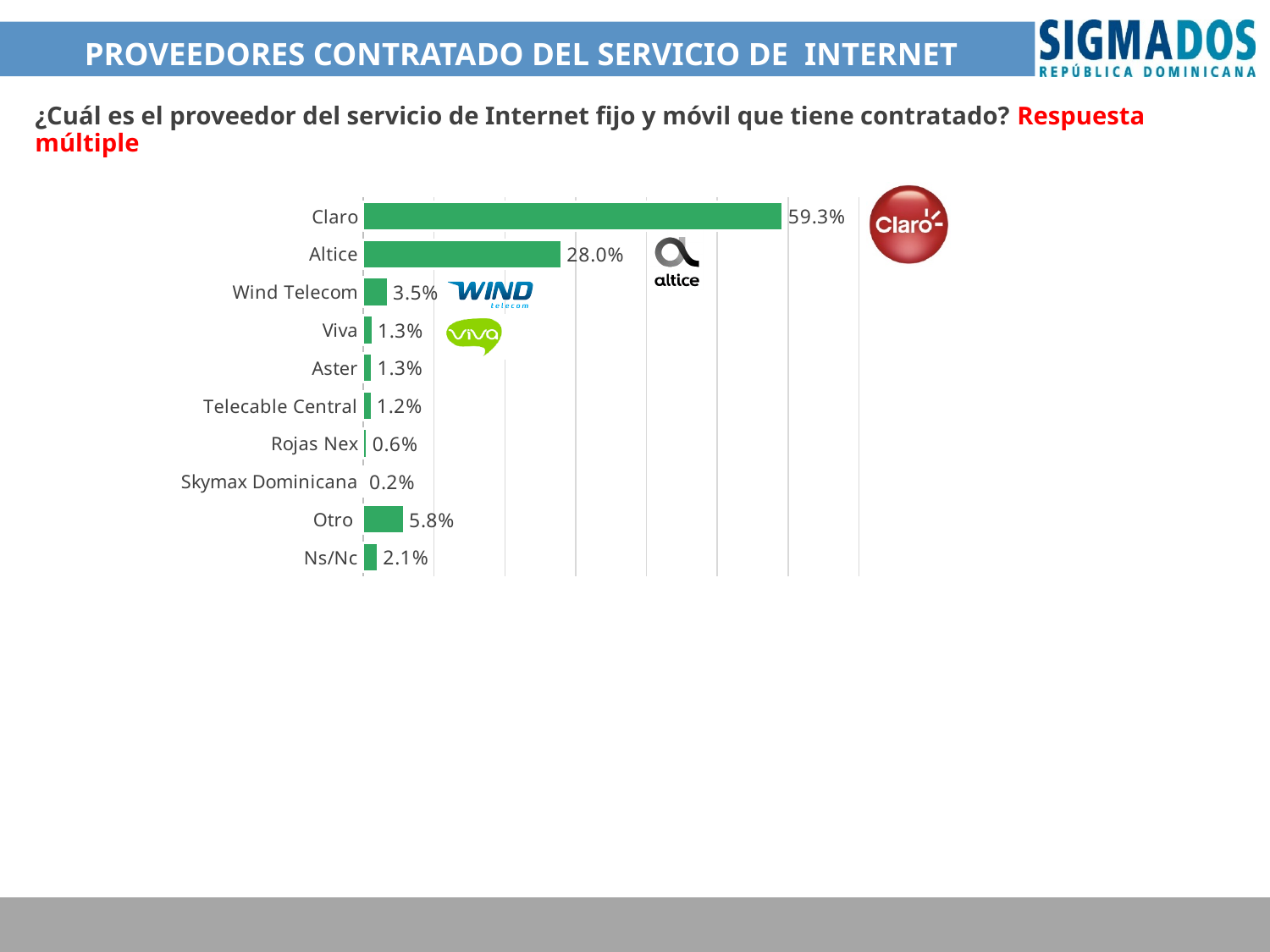
How many categories are shown in the chart? 10 What is the value for Claro? 59.3% Which is larger, the value for Otro or the value for Wind Telecom? Otro What is the value for Altice? 28.0% What is the value for Wind Telecom? 3.5% What is the value for Ns/Nc? 2.1% What is the value for Telecable Central? 1.2% What is the difference between the values for Claro and Altice? 31.3% Which provider has the highest value? Claro Which category has the lowest value? Skymax Dominicana What is the value for Skymax Dominicana? 0.2% What kind of chart is shown on the slide? Bar chart